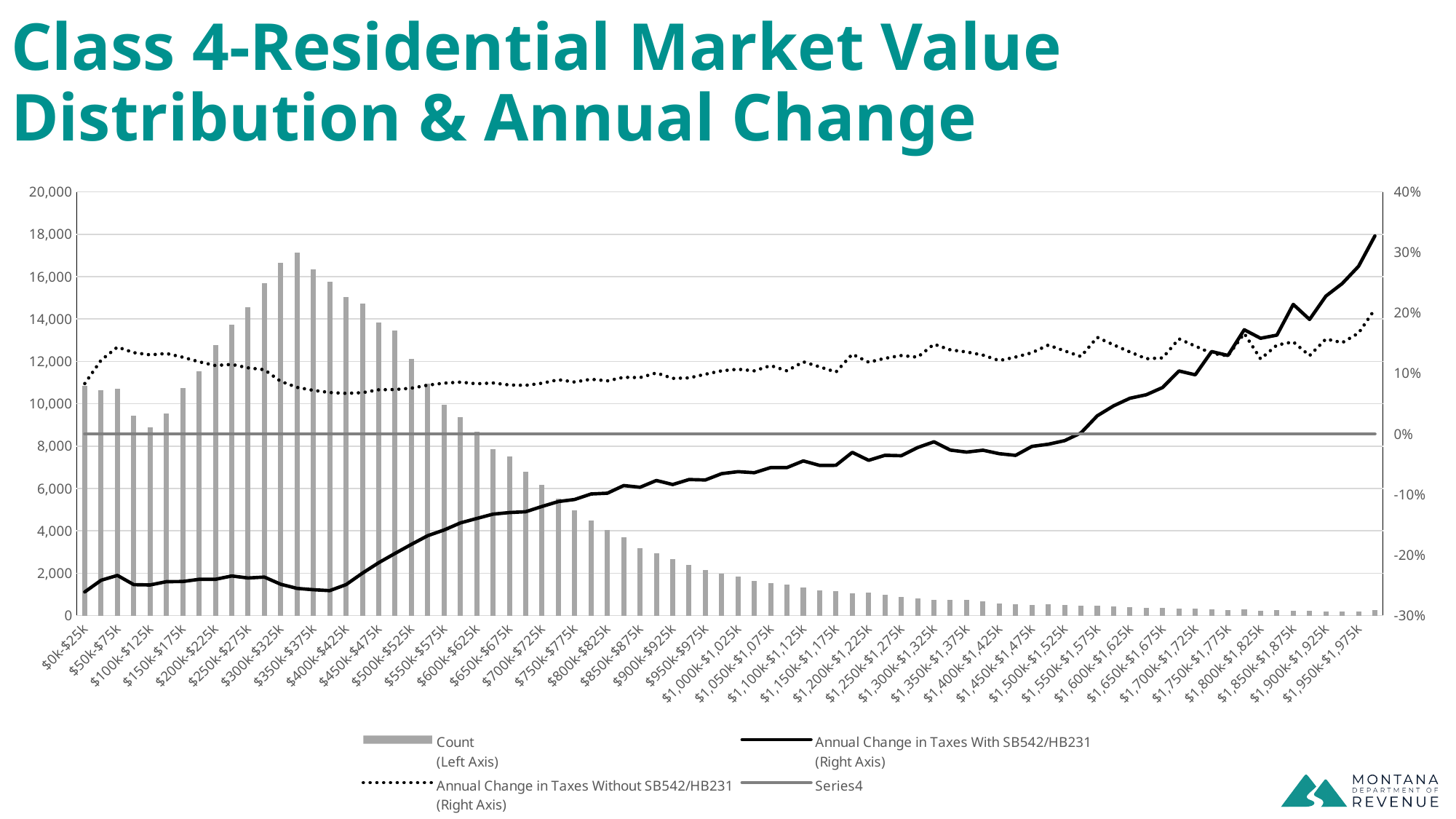
Is the Annual Change in Taxes With SB542/HB231 for $1,950k-$1,975k greater or less than 30%? less At $1,950k-$1,975k, which is higher: the Annual Change in Taxes With SB542/HB231 or Without SB542/HB231? With SB542/HB231 Is the Count for $350k-$375k greater or less than 16,000? greater Is the Annual Change in Taxes With SB542/HB231 for $0k-$25k greater or less than -20%? less What kind of chart is shown on the slide? A combination bar and line chart Does the Annual Change in Taxes With SB542/HB231 line generally rise or fall as market value increases along the x axis? rise How many series does the legend list? 4 At $0k-$25k, which is higher: the Annual Change in Taxes With SB542/HB231 or Without SB542/HB231? Without SB542/HB231 Which series is plotted on the left axis according to the legend? Count